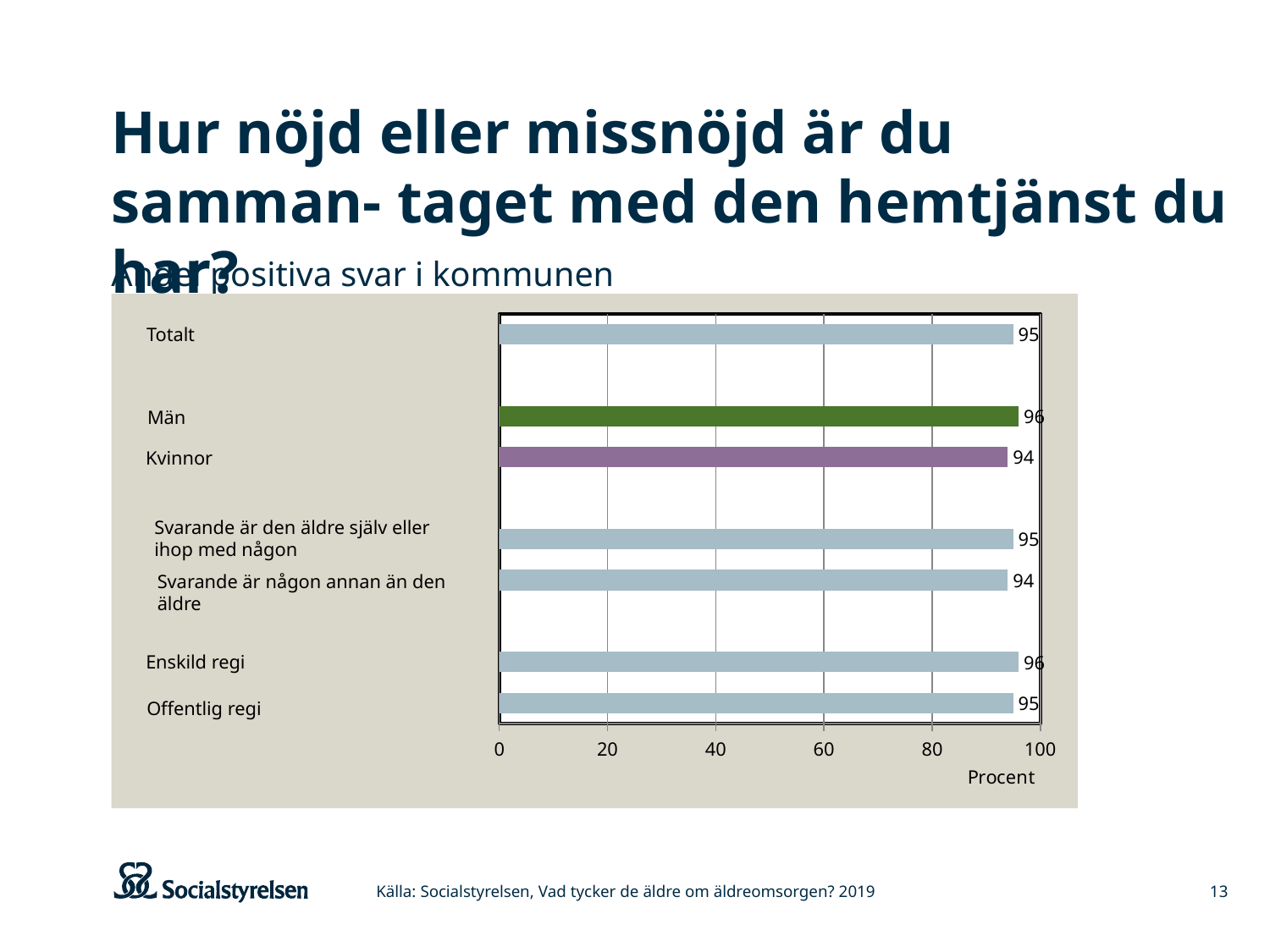
What is the value for Män? 96 Which is larger, the value for Män or the value for Kvinnor? Män What is the difference between the values for Män and Kvinnor? 2 What is the value for Enskild regi? 96 How many categories (bars) are shown in the chart? 7 What is the value for Offentlig regi? 95 What is the difference between the values for Enskild regi and Offentlig regi? 1 What is the value for Totalt? 95 What is the value for 'Svarande är någon annan än den äldre'? 94 What is the value for Kvinnor? 94 Is the value for Totalt greater or less than 80? greater What kind of chart is shown on the slide? bar chart